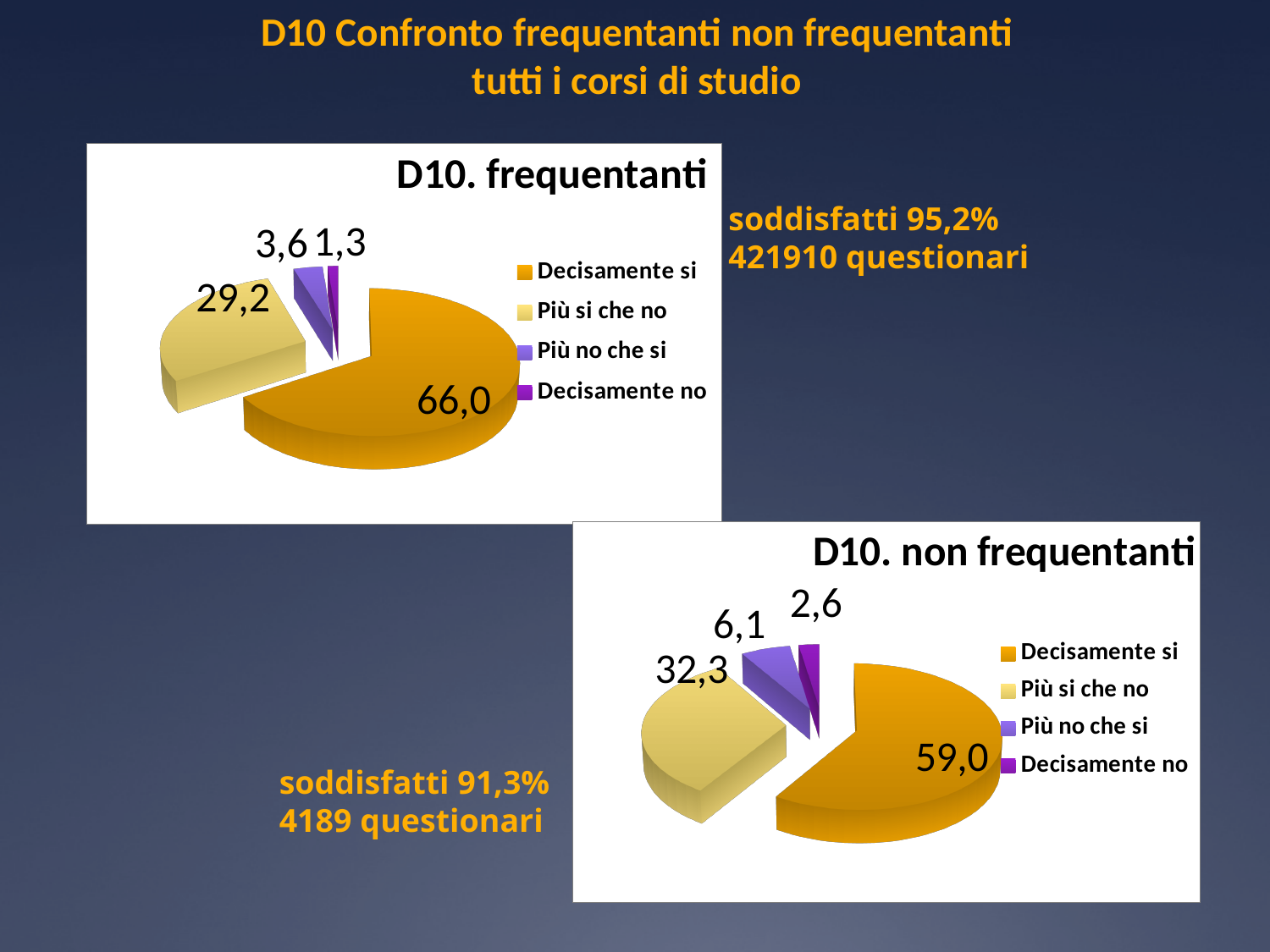
In the "D10. non frequentanti" chart, what is the value for "Più si che no"? 32,3 In the "D10. non frequentanti" chart, what is the value for "Decisamente no"? 2,6 Which chart has the larger value for "Più no che si", "D10. frequentanti" or "D10. non frequentanti"? D10. non frequentanti What is the difference between the "Decisamente si" values in the "D10. frequentanti" and "D10. non frequentanti" charts? 7,0 What is the title of the chart in the lower right of the slide? D10. non frequentanti In the "D10. frequentanti" chart, what colour is the "Più si che no" slice? Light yellow What type of chart is "D10. frequentanti"? Pie chart In the "D10. frequentanti" chart, which category has the smallest slice? Decisamente no How many slices does the "D10. non frequentanti" pie chart have? 4 In the "D10. frequentanti" chart, what is the value for "Decisamente si"? 66,0 In the "D10. frequentanti" chart, what is the difference between "Più no che si" and "Decisamente no"? 2,3 In the "D10. non frequentanti" chart, which category has the largest slice? Decisamente si